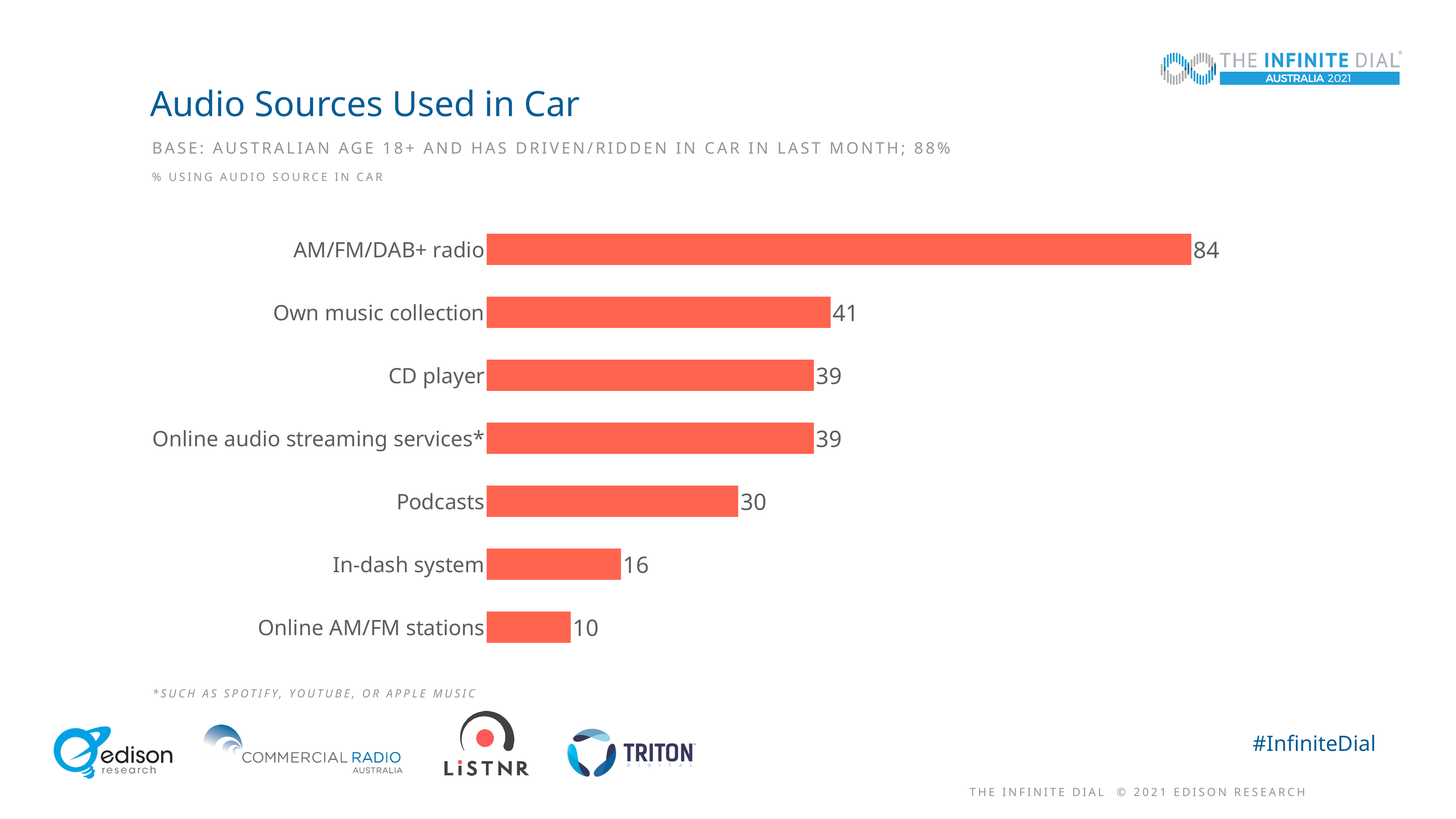
What is the difference between AM/FM/DAB+ radio and Own music collection? 43 What is the difference between Podcasts and Online AM/FM stations? 20 What is the title of the chart? Audio Sources Used in Car How many audio sources are shown in the chart? 7 What is the value for Own music collection? 41 Which audio source has the highest value? AM/FM/DAB+ radio What percentage use AM/FM/DAB+ radio in the car? 84 What is the value for Podcasts? 30 What kind of chart is shown on the slide? Bar chart What is the value for In-dash system? 16 Which is larger, Podcasts or In-dash system? Podcasts Which audio source has the lowest value? Online AM/FM stations